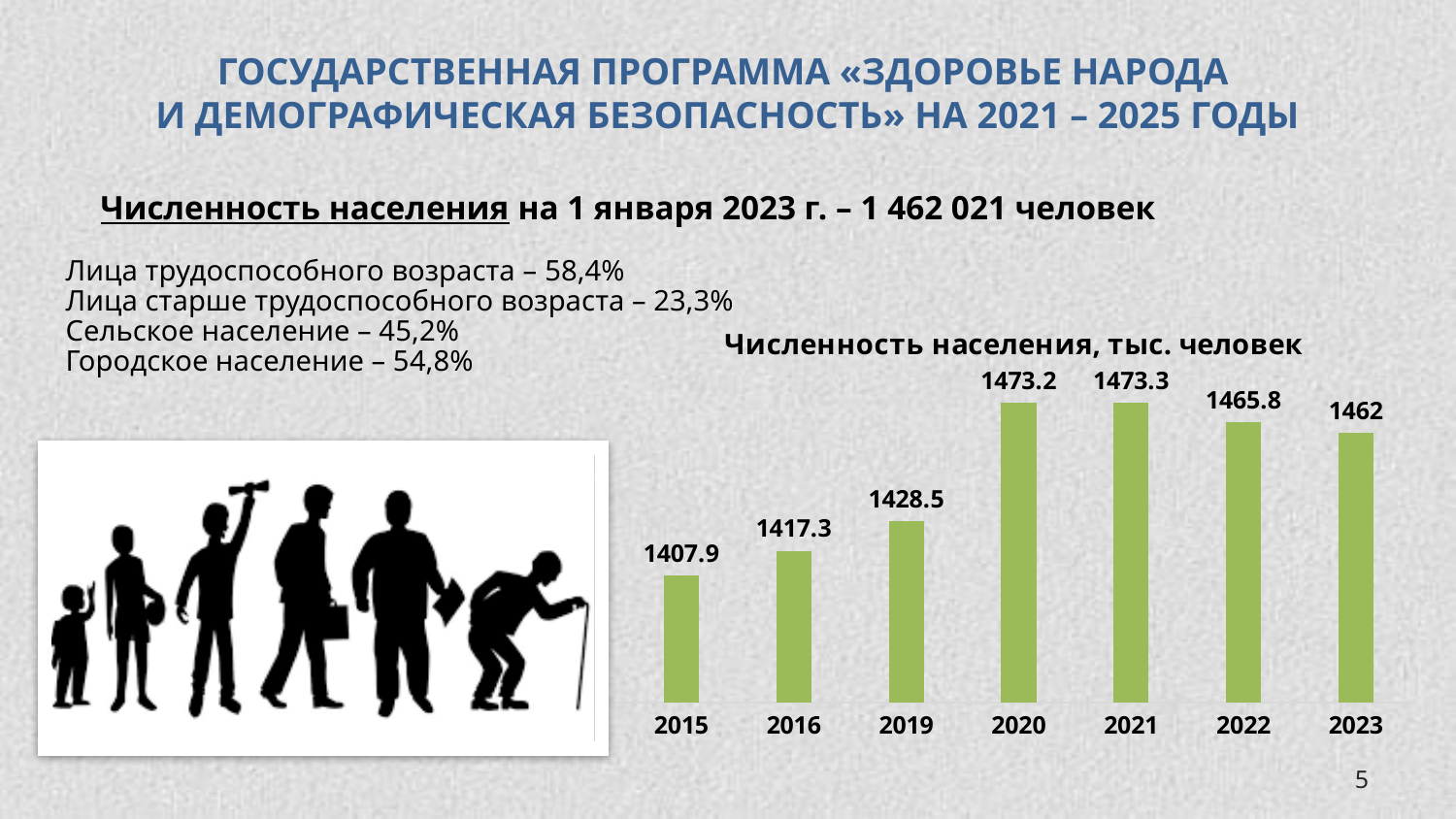
Does the population value rise or fall from 2015 to 2020? Rise Which year has the larger population value, 2019 or 2022? 2022 What is the population value shown for 2015 in the chart? 1407.9 Which year has the lowest population value in the chart? 2015 What is the population value shown for 2019 in the chart? 1428.5 What kind of chart is used to show the population figures? Bar chart How many years are shown on the x axis of the chart? 7 What is the population value shown for 2020 in the chart? 1473.2 What is the title of the chart? Численность населения, тыс. человек What is the population value shown for 2023 in the chart? 1462 What is the difference between the population values for 2023 and 2015? 54.1 What is the difference between the population values for 2020 and 2019? 44.7